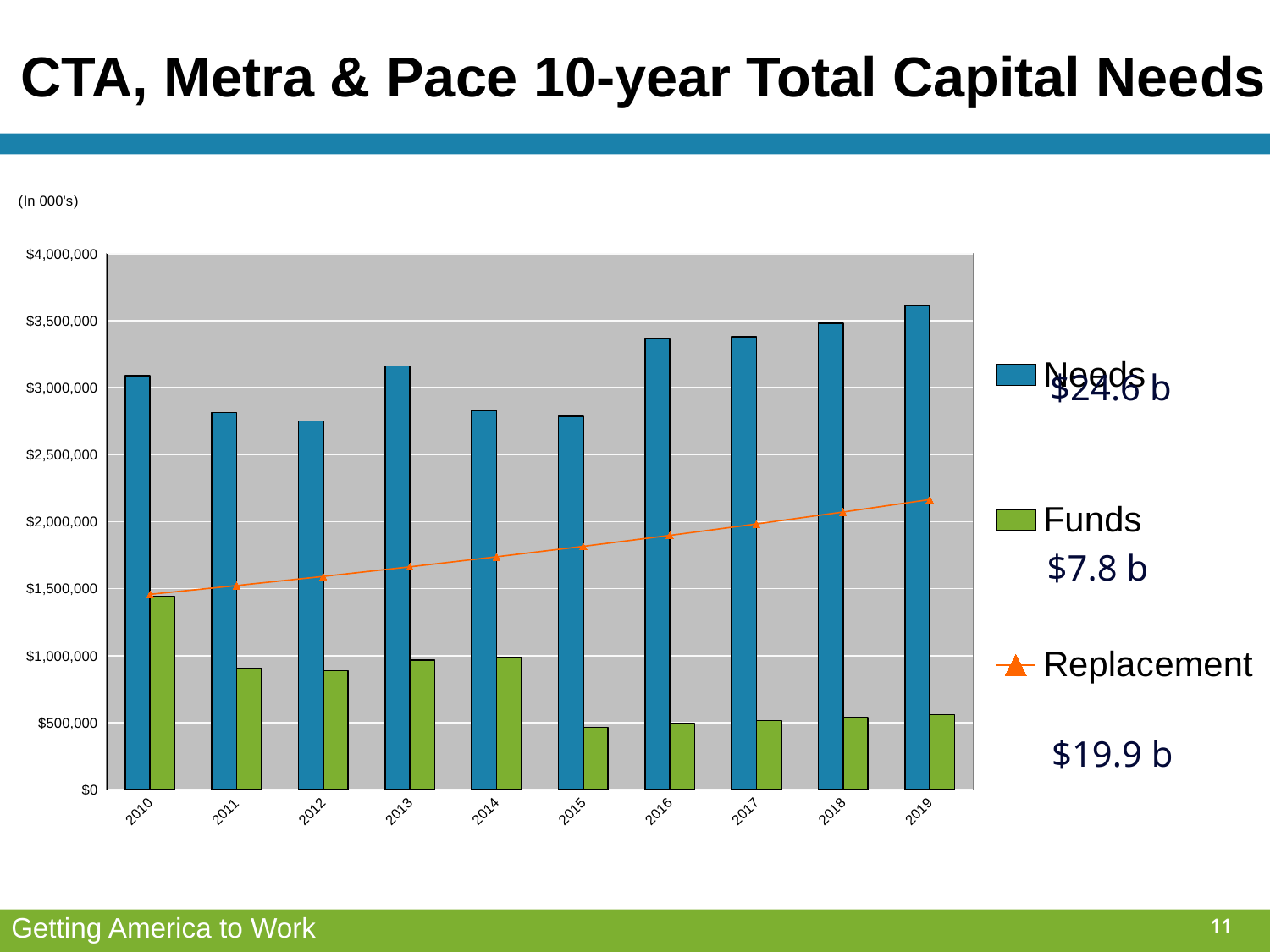
Is the Replacement value for 2019 greater or less than $2,000,000? greater How many years are shown on the x axis of the chart? 10 Which year has the highest Needs bar? 2019 Is the Funds value for 2019 greater or less than $500,000? greater What kind of chart is shown on the slide? Bar chart with a line series Which year has the highest Funds bar? 2010 Which is larger, the Needs bar for 2019 or the Needs bar for 2010? 2019 What 10-year total is shown next to the Funds legend entry? $7.8 b Is the Needs value for 2011 greater or less than $3,000,000? less Does the Replacement line rise or fall from 2010 to 2019? rises How many series does the chart legend list? 3